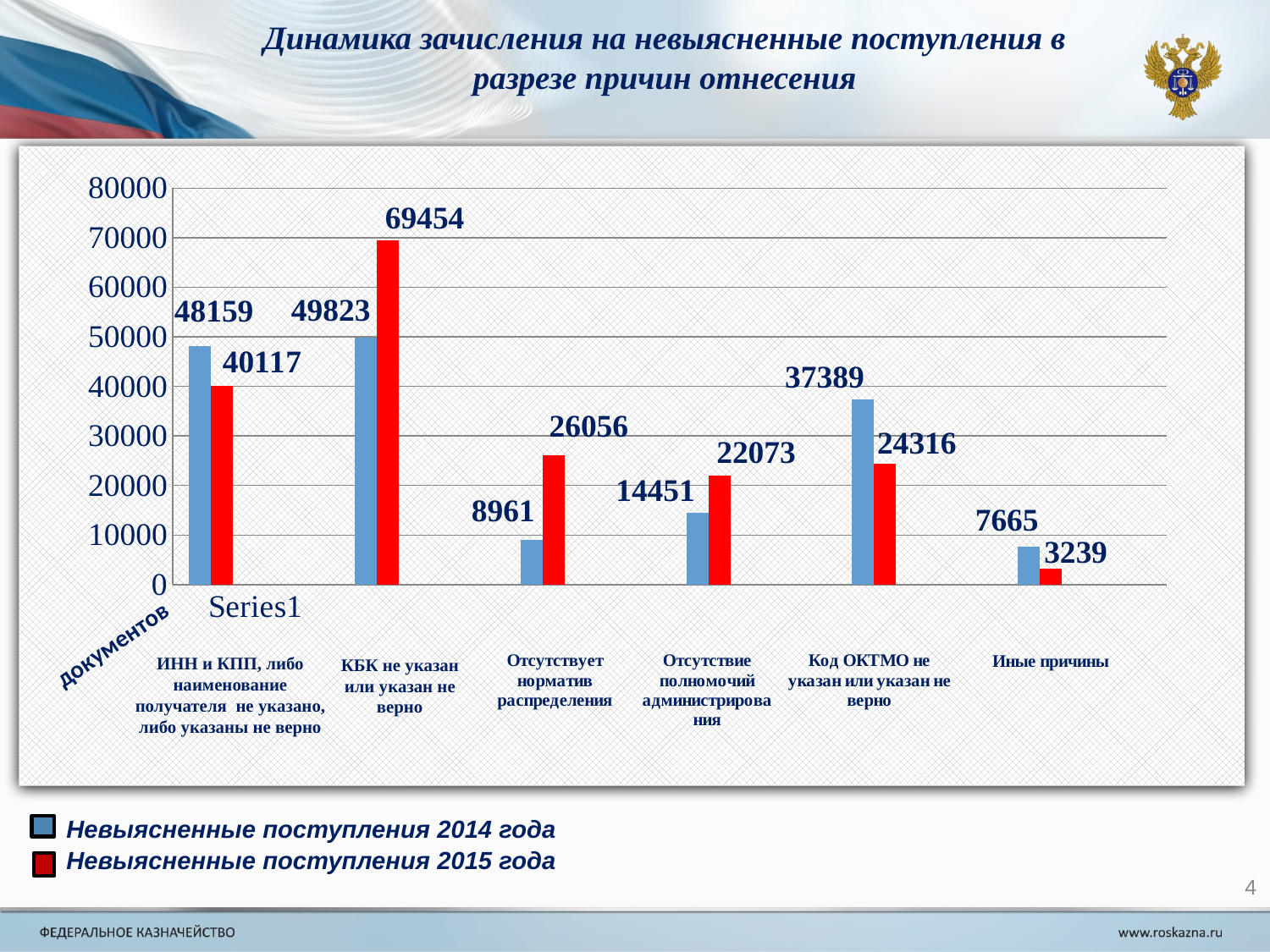
Which category has the lowest value in the 'Невыясненные поступления 2014 года' series? Иные причины What is the difference between the 2015 and 2014 values for 'КБК не указан или указан не верно'? 19631 What is the value for 'КБК не указан или указан не верно' in the 'Невыясненные поступления 2015 года' series? 69454 For 'Отсутствие полномочий администрирования', which series has the larger value, 2014 or 2015? 2015 What is the value for 'Иные причины' in the 'Невыясненные поступления 2014 года' series? 7665 What is the difference between the 2014 and 2015 values for 'Код ОКТМО не указан или указан не верно'? 13073 What kind of chart is shown on the slide? bar chart Is the 2014 value for 'ИНН и КПП, либо наименование получателя не указано, либо указаны не верно' greater or less than 40000? greater Which category has the highest value in the 'Невыясненные поступления 2015 года' series? КБК не указан или указан не верно How many series does the legend list? 2 What is the value for 'Отсутствует норматив распределения' in the 'Невыясненные поступления 2015 года' series? 26056 How many categories are shown on the x axis of the chart? 6